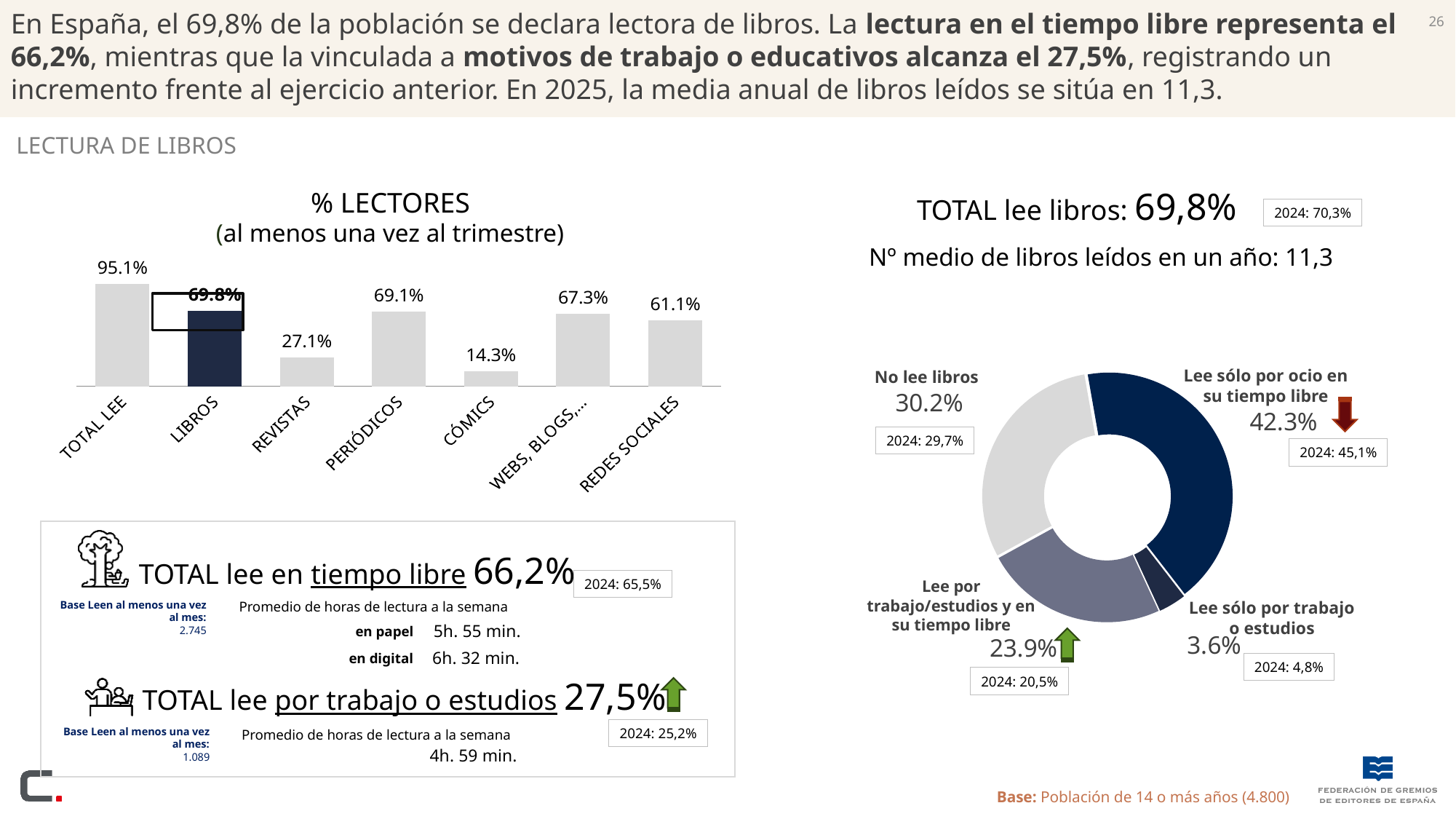
In the '% LECTORES' bar chart, what is the difference between the values for LIBROS and REDES SOCIALES? 8.7% How many categories are shown in the '% LECTORES' bar chart? 7 In the '% LECTORES' bar chart, which is larger: the value for WEBS, BLOGS,... or the value for REDES SOCIALES? WEBS, BLOGS,... In the donut chart on the right, what share corresponds to 'Lee sólo por ocio en su tiempo libre'? 42.3% In the donut chart on the right, what is the value for 'No lee libros'? 30.2% In the '% LECTORES' bar chart, what is the value for REVISTAS? 27.1% In the '% LECTORES' bar chart, what is the value for PERIÓDICOS? 69.1% In the '% LECTORES' bar chart, which category has the lowest value? CÓMICS In the donut chart on the right, which slice is the smallest? Lee sólo por trabajo o estudios In the '% LECTORES' bar chart, which category has the highest value? TOTAL LEE In the donut chart on the right, what is the difference between 'Lee por trabajo/estudios y en su tiempo libre' and 'Lee sólo por trabajo o estudios'? 20.3% What kind of chart is the '% LECTORES' chart? Bar chart